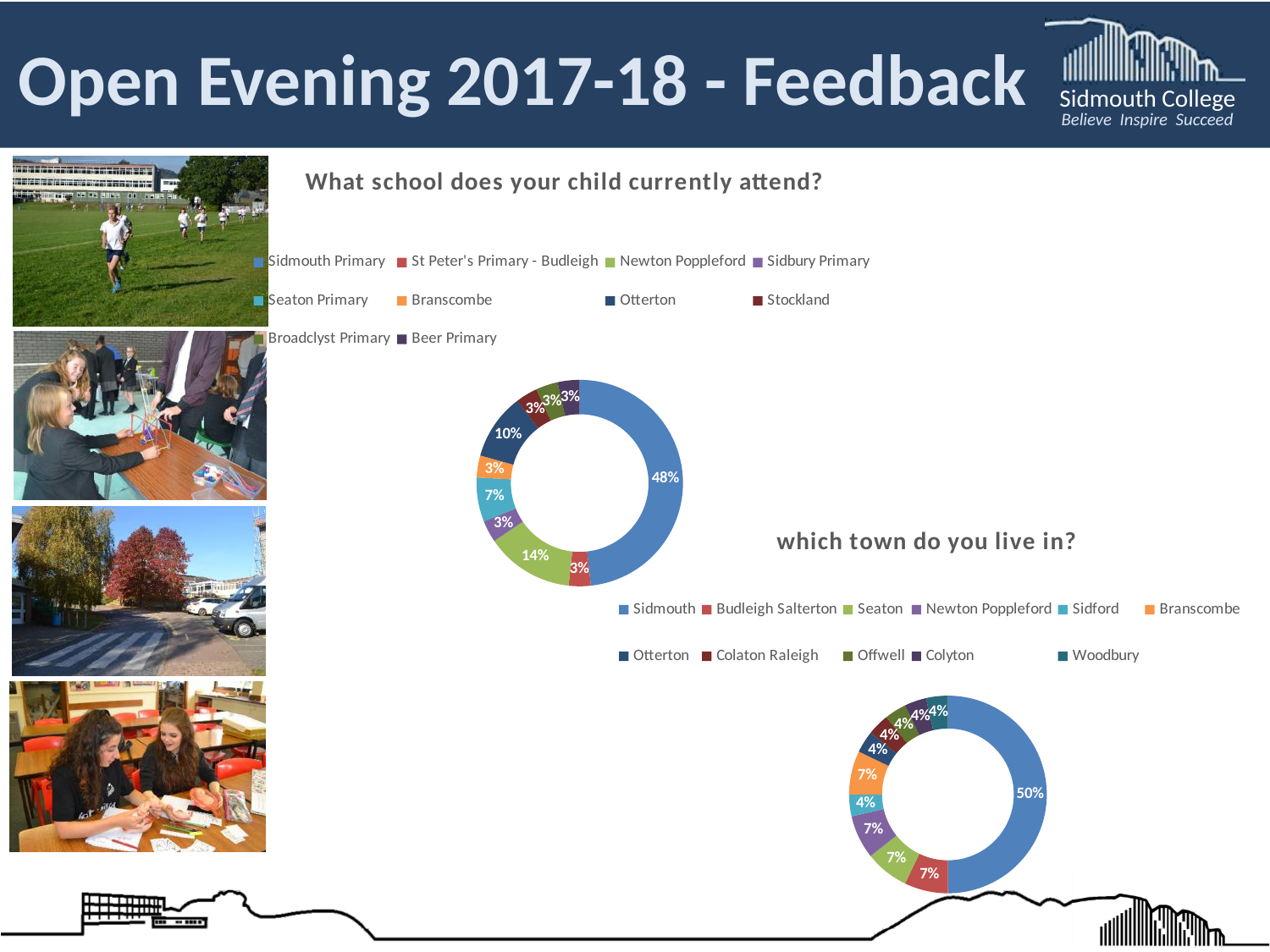
In the chart 'which town do you live in?', which is larger: the share for Sidmouth or the share for Seaton? Sidmouth In the chart 'What school does your child currently attend?', what share of responses is Newton Poppleford? 14% What type of chart is used for 'What school does your child currently attend?' Doughnut chart In the chart 'which town do you live in?', which town has the largest share? Sidmouth In the chart 'What school does your child currently attend?', what is the difference between the Sidmouth Primary share and the Newton Poppleford share? 34% In the chart 'which town do you live in?', what share of responses is Sidmouth? 50% In the chart 'What school does your child currently attend?', how many schools does the legend list? 10 In the chart 'What school does your child currently attend?', which school has the largest share? Sidmouth Primary In the chart 'which town do you live in?', what share of responses is Budleigh Salterton? 7% In the chart 'What school does your child currently attend?', what share of responses is Sidmouth Primary? 48% In the chart 'What school does your child currently attend?', what share of responses is Otterton? 10% In the chart 'which town do you live in?', how many towns does the legend list? 11